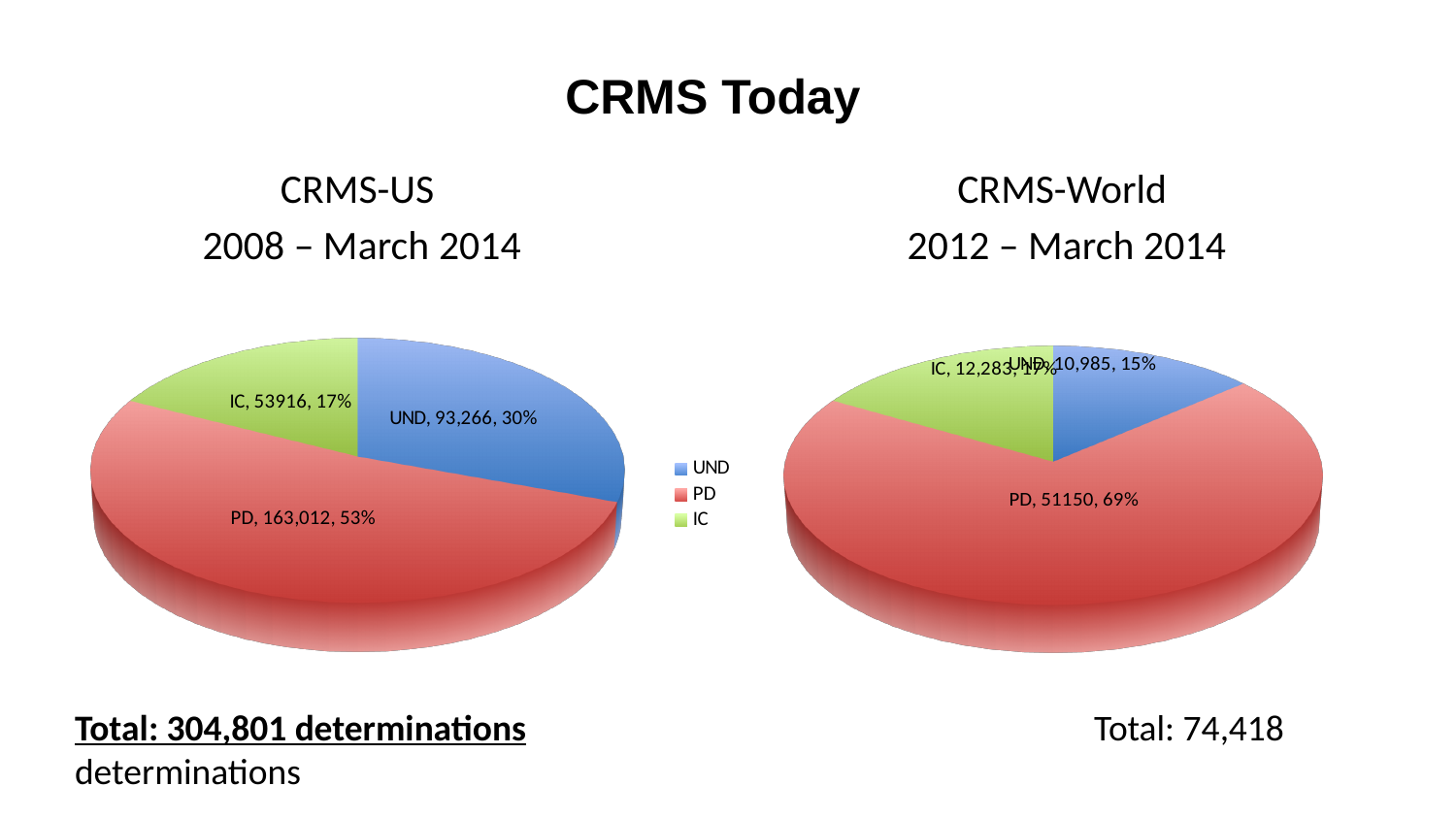
In the CRMS-World pie chart, which category has the largest slice? PD In the CRMS-World pie chart, what value is shown for UND? 10,985 How many entries does the legend list? 3 In the CRMS-US pie chart, which category has the smallest slice? IC In the CRMS-US pie chart, what value is shown for IC? 53916 In the CRMS-US pie chart, what value is shown for PD? 163,012 What type of chart is used for CRMS-US and CRMS-World? Pie chart In the CRMS-World pie chart, what percentage share does PD have? 69% In the CRMS-US pie chart, what is the difference between the PD value and the UND value? 69,746 In the CRMS-World pie chart, what value is shown for PD? 51150 In the CRMS-US pie chart, what percentage share does UND have? 30% In the CRMS-US pie chart, which category has the largest slice? PD